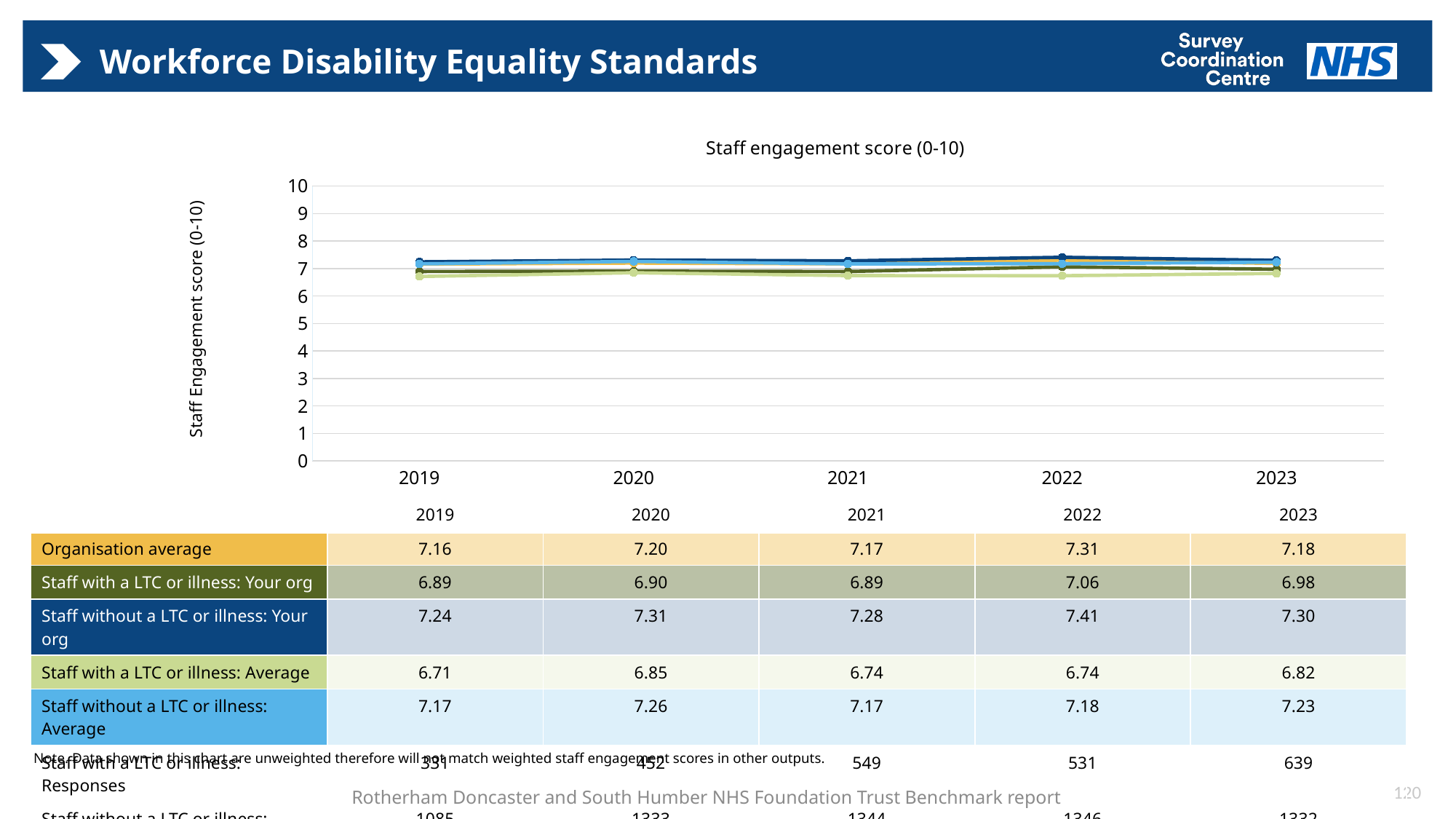
Does the score for Staff with a LTC or illness: Your org rise or fall from 2019 to 2022? rise Is the Organisation average score in 2020 greater or less than 5? greater What is the Organisation average staff engagement score in 2022? 7.31 In 2023, which is higher: Staff with a LTC or illness: Your org or Staff with a LTC or illness: Average? Staff with a LTC or illness: Your org How many years are shown on the x axis of the chart? 5 How many series are plotted in the chart? 5 In which year is the score for Staff with a LTC or illness: Average lowest? 2019 What is the staff engagement score for Staff with a LTC or illness: Your org in 2019? 6.89 In 2022, what is the difference between the scores for Staff without a LTC or illness: Your org and Staff with a LTC or illness: Your org? 0.35 What is the title of the chart? Staff engagement score (0-10) What kind of chart is shown on the slide? line chart In which year is the score for Staff without a LTC or illness: Your org highest? 2022